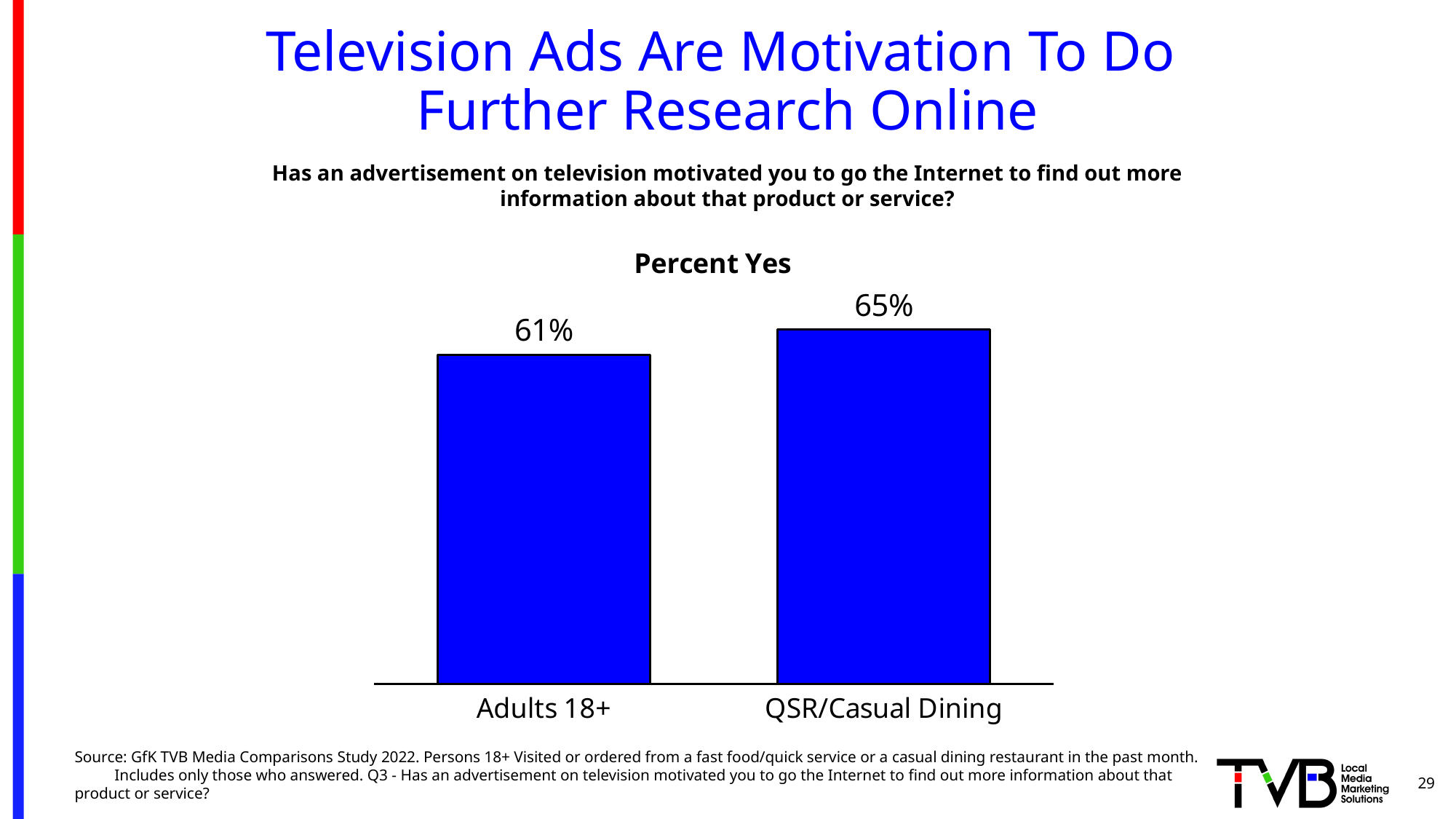
How many categories are shown in the chart? 2 What is the Percent Yes value for Adults 18+? 61% Which category has the lower Percent Yes value? Adults 18+ What is the title of the chart? Percent Yes Is the Percent Yes value larger for Adults 18+ or for QSR/Casual Dining? QSR/Casual Dining What kind of chart is shown on the slide? Bar chart Which category has the higher Percent Yes value? QSR/Casual Dining What colour are the bars in the chart? Blue What is the Percent Yes value for QSR/Casual Dining? 65% What is the difference in Percent Yes between QSR/Casual Dining and Adults 18+? 4 percentage points